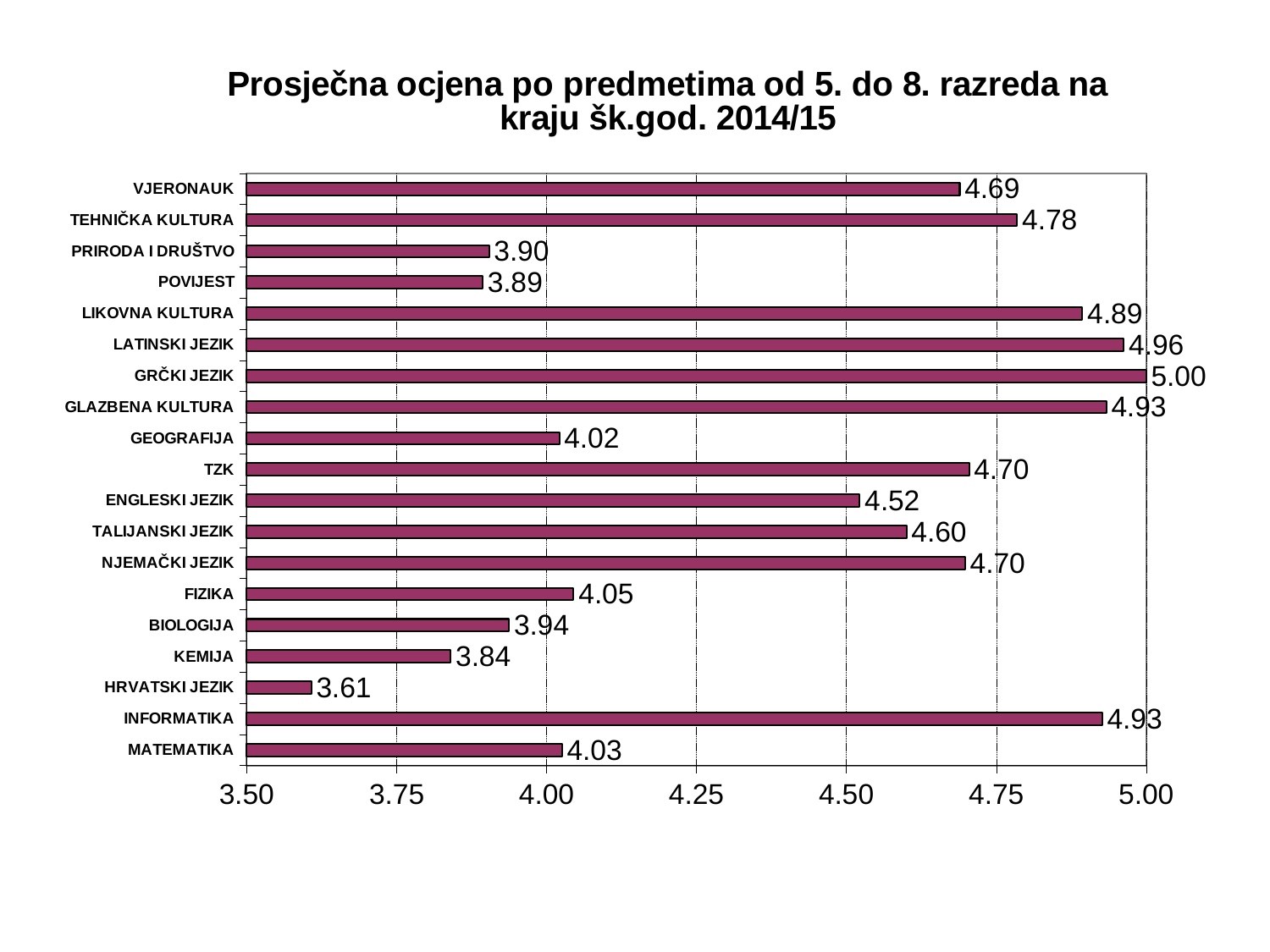
What is the average grade for TEHNIČKA KULTURA? 4.78 Is the value for BIOLOGIJA greater or less than 4.00? less How many subjects are shown in the chart? 19 Which subject has the lowest average grade? HRVATSKI JEZIK Which has a higher average grade, FIZIKA or KEMIJA? FIZIKA What is the difference between the average grades for INFORMATIKA and MATEMATIKA? 0.90 What kind of chart is shown on the slide? bar chart Which subject has the highest average grade? GRČKI JEZIK What is the average grade for MATEMATIKA? 4.03 What is the average grade for HRVATSKI JEZIK? 3.61 What is the difference between the average grades for LATINSKI JEZIK and ENGLESKI JEZIK? 0.44 What is the lowest value shown on the horizontal axis? 3.50